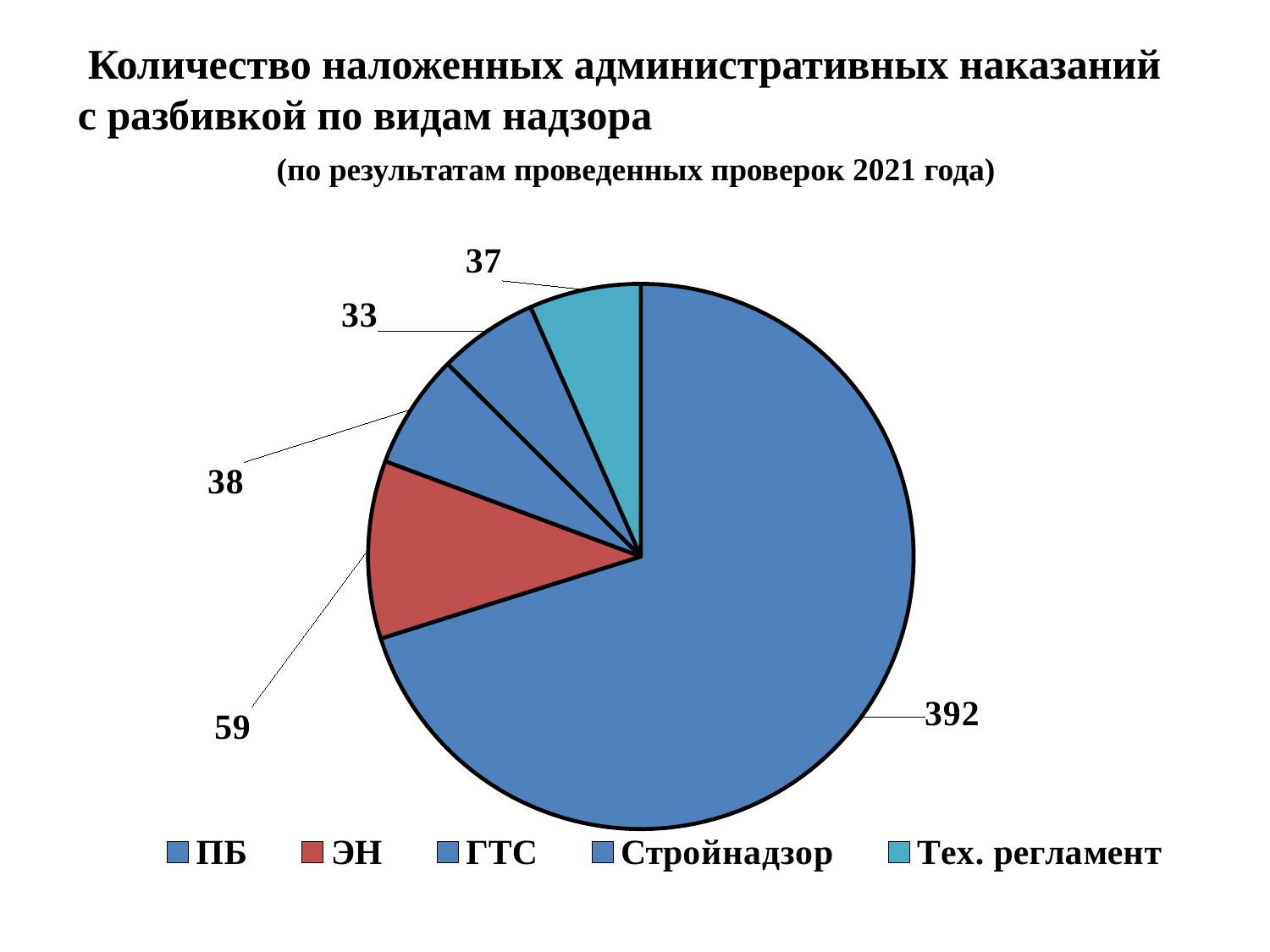
Which category has the smallest value? Стройнадзор Which is larger, the value for ЭН or the value for Тех. регламент? ЭН What is the value for Тех. регламент? 37 What is the value for ГТС? 38 What is the value for ПБ? 392 What type of chart is shown on the slide? pie chart Which category has the largest slice? ПБ What is the value for Стройнадзор? 33 What is the difference between the values for ПБ and ЭН? 333 Which category is shown in red? ЭН How many categories does the pie chart have? 5 What is the value for ЭН? 59